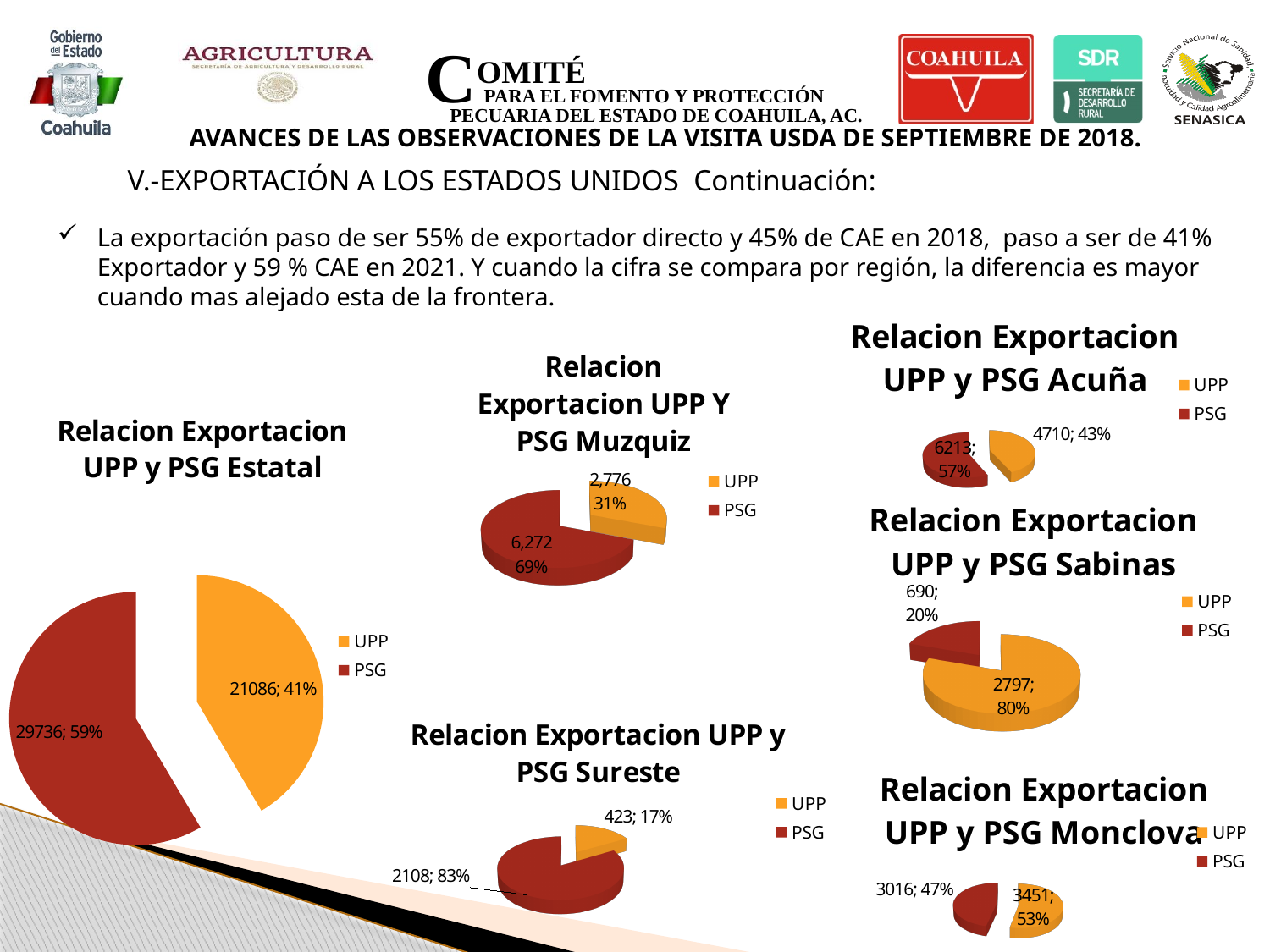
In the 'Relacion Exportacion UPP Y PSG Muzquiz' chart, what value is shown for PSG? 6,272 In the 'Relacion Exportacion UPP y PSG Monclova' chart, what share of the pie does PSG have? 47% How many series does the legend of the 'Relacion Exportacion UPP y PSG Acuña' chart list? 2 In the 'Relacion Exportacion UPP Y PSG Muzquiz' chart, what share of the pie does UPP have? 31% In the 'Relacion Exportacion UPP y PSG Sabinas' chart, which category has the larger slice, UPP or PSG? UPP What kind of chart is the 'Relacion Exportacion UPP y PSG Estatal' chart? Pie chart In the 'Relacion Exportacion UPP y PSG Acuña' chart, what value is shown for UPP? 4710; 43% In the 'Relacion Exportacion UPP y PSG Sureste' chart, what is the difference between the PSG value and the UPP value? 1685 In the 'Relacion Exportacion UPP y PSG Estatal' chart, what share of the pie does UPP have? 41% In the 'Relacion Exportacion UPP y PSG Monclova' chart, what is the total of the UPP and PSG values? 6467 In the 'Relacion Exportacion UPP y PSG Estatal' chart, what value is shown for PSG? 29736; 59% In the 'Relacion Exportacion UPP y PSG Sabinas' chart, what value is shown for PSG? 690; 20%